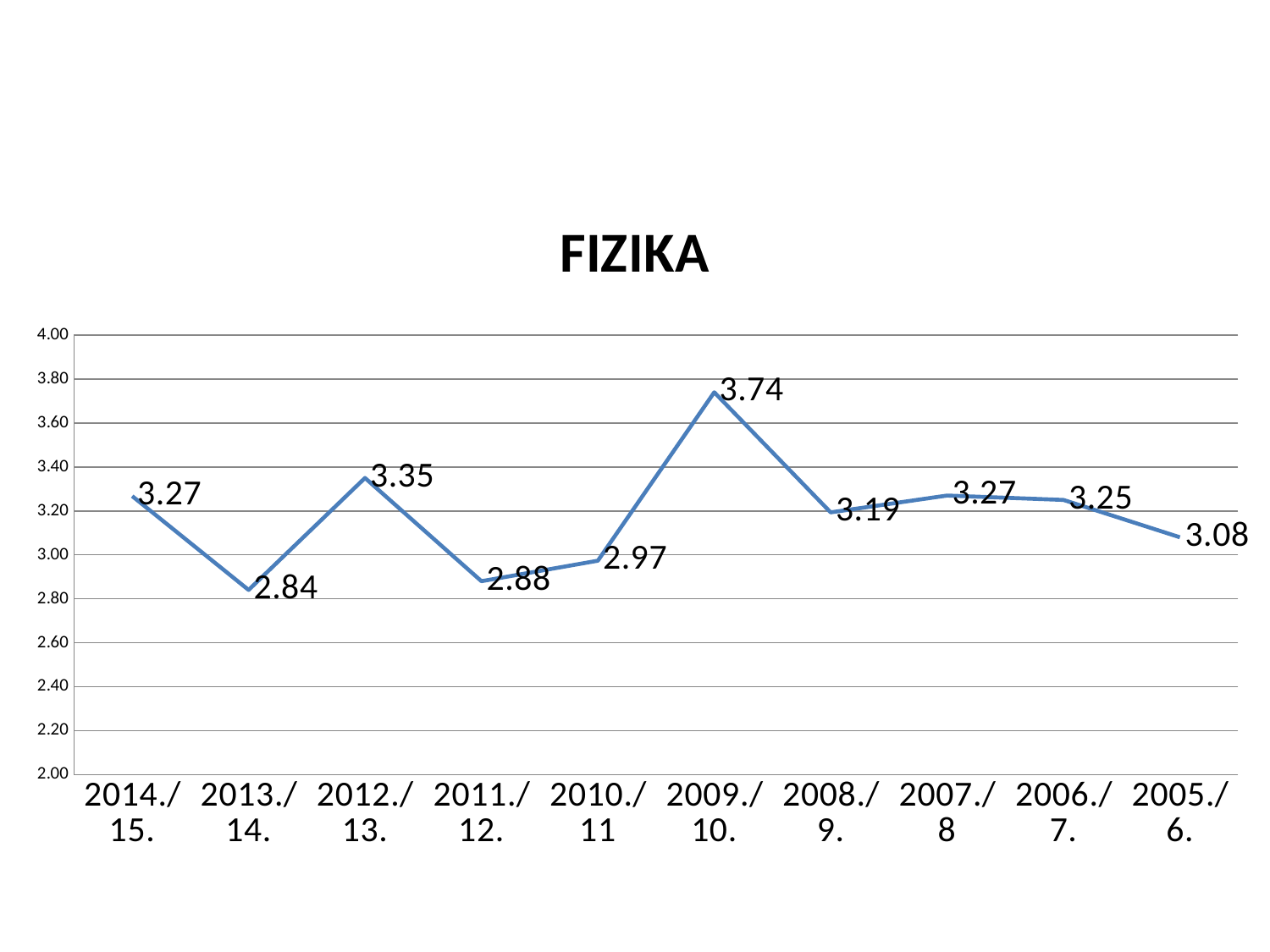
Does the value rise or fall from 2006./7. to 2005./6.? fall What kind of chart is shown? line chart Is the value for 2010./11 greater or less than 3.00? less Which school year has the lowest value? 2013./14. What is the value for 2013./14.? 2.84 What is the title of the chart? FIZIKA How many school years are plotted on the chart? 10 Which is larger, the value for 2012./13. or the value for 2011./12.? 2012./13. What is the value for 2009./10.? 3.74 Which school year has the highest value? 2009./10. What is the difference between the values for 2009./10. and 2008./9.? 0.55 What is the value for 2005./6.? 3.08